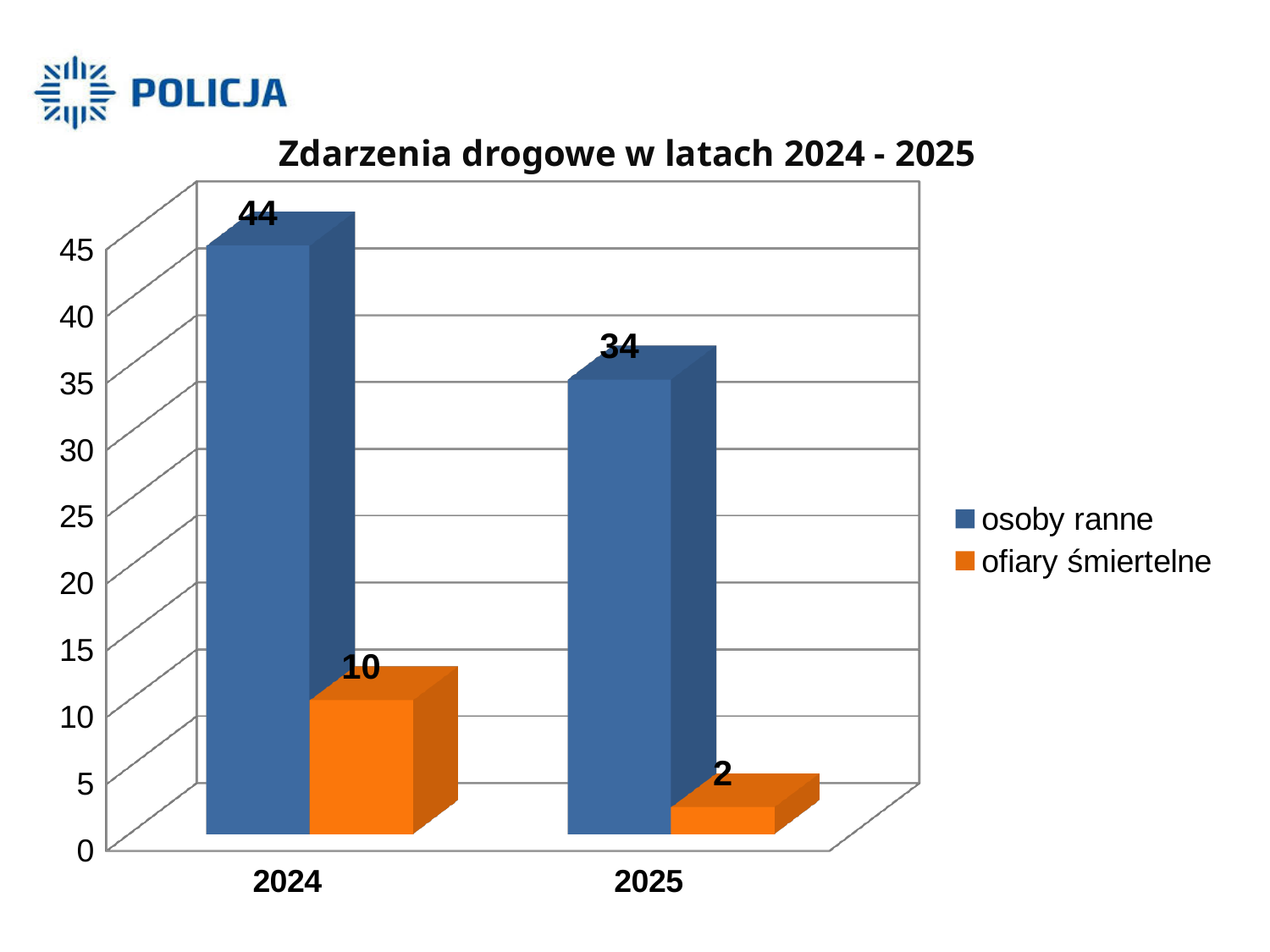
What is the title of the chart? Zdarzenia drogowe w latach 2024 - 2025 Which is larger: osoby ranne in 2025 or ofiary śmiertelne in 2024? osoby ranne in 2025 How many series does the legend list? 2 What is the value for osoby ranne in 2024? 44 What kind of chart is shown on the slide? bar chart What is the value for ofiary śmiertelne in 2025? 2 In which year is the value for ofiary śmiertelne lowest? 2025 What is the value for osoby ranne in 2025? 34 In which year is the value for osoby ranne highest? 2024 What is the difference between ofiary śmiertelne in 2024 and in 2025? 8 What is the value for ofiary śmiertelne in 2024? 10 What is the difference between osoby ranne in 2024 and in 2025? 10